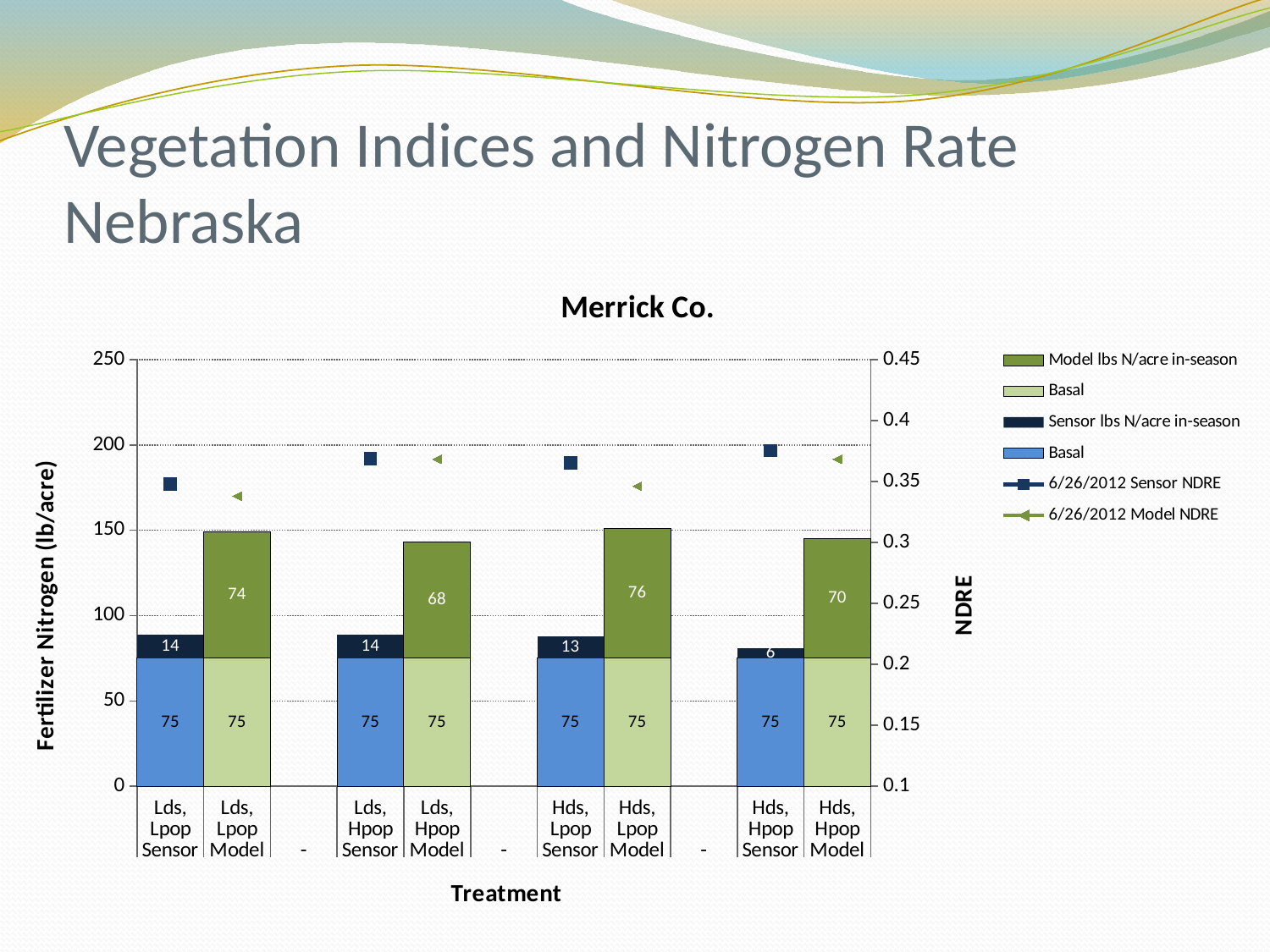
Which treatment has the highest Model lbs N/acre in-season value? Hds, Lpop Model Is the Model in-season value for Lds, Hpop Model larger or smaller than the Model in-season value for Hds, Hpop Model? smaller Which treatment has the lowest Sensor lbs N/acre in-season value? Hds, Hpop Sensor What is the total height of the stacked bar for the Hds, Hpop Sensor treatment? 81 What is the title of the chart? Merrick Co. What is the Sensor lbs N/acre in-season value for the Hds, Hpop Sensor treatment? 6 Is the 6/26/2012 Sensor NDRE value for the Lds, Lpop Sensor treatment greater or less than 0.4? less What is the difference between the Model in-season values for Hds, Lpop Model and Lds, Hpop Model? 8 What is the total height of the stacked bar for the Lds, Lpop Model treatment? 149 What is the Basal value for the Hds, Lpop Model treatment? 75 What is the Model lbs N/acre in-season value for the Lds, Lpop Model treatment? 74 How many entries does the legend list? 6